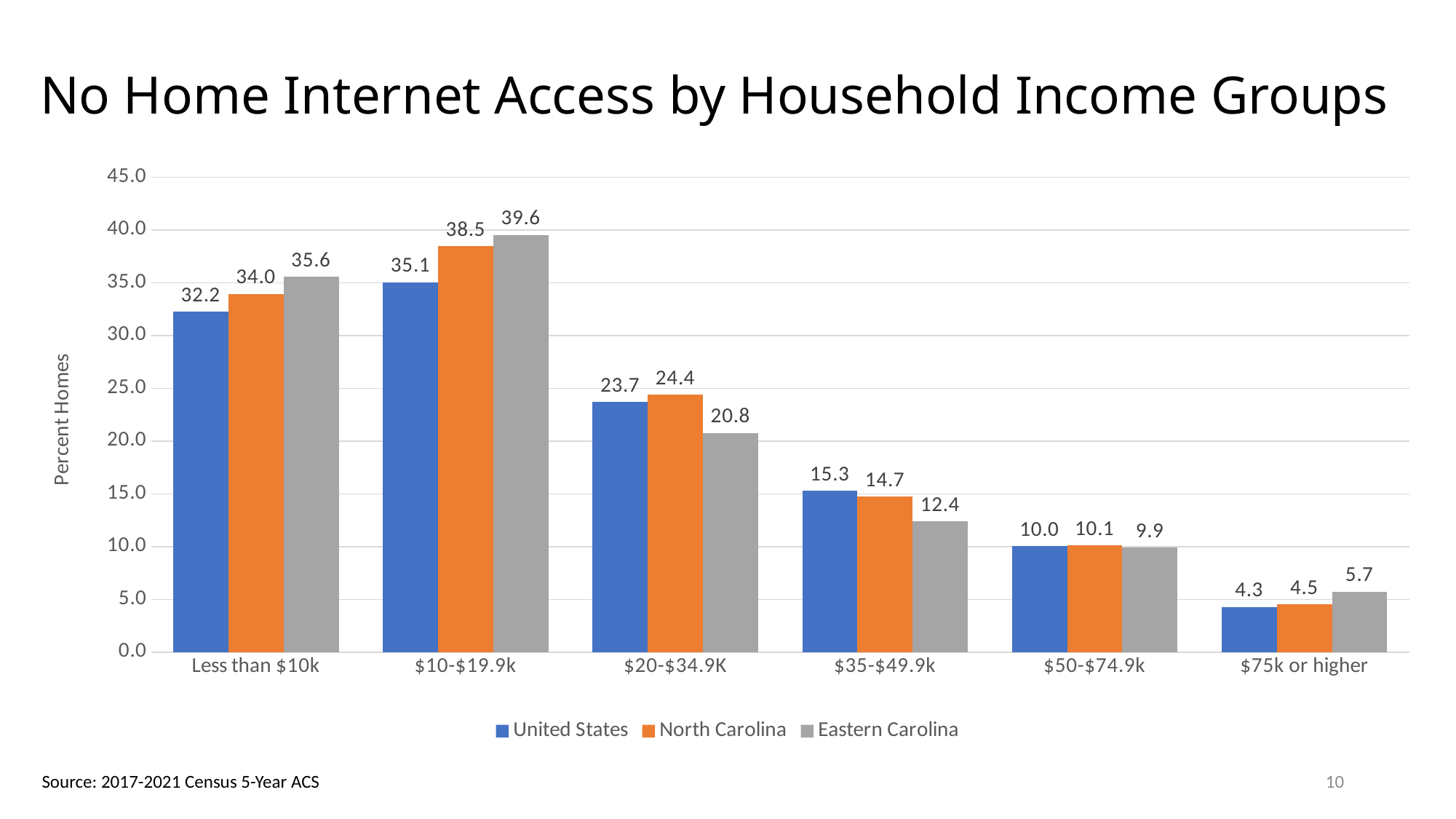
Do the Eastern Carolina values generally rise or fall from the $10-$19.9k group to the $75k or higher group? Fall Which income group has the highest value for North Carolina? $10-$19.9k What is the value for North Carolina in the Less than $10k income group? 34.0 What is the value for United States in the $35-$49.9k income group? 15.3 What is the label of the y axis? Percent Homes In the $20-$34.9K income group, which is larger: the United States value or the Eastern Carolina value? United States How many income groups are shown on the x axis? 6 How many series does the legend list? 3 What kind of chart is shown on the slide? Bar chart What is the difference between the North Carolina and United States values in the $20-$34.9K income group? 0.7 Which income group has the lowest value for Eastern Carolina? $75k or higher What is the value for Eastern Carolina in the $10-$19.9k income group? 39.6